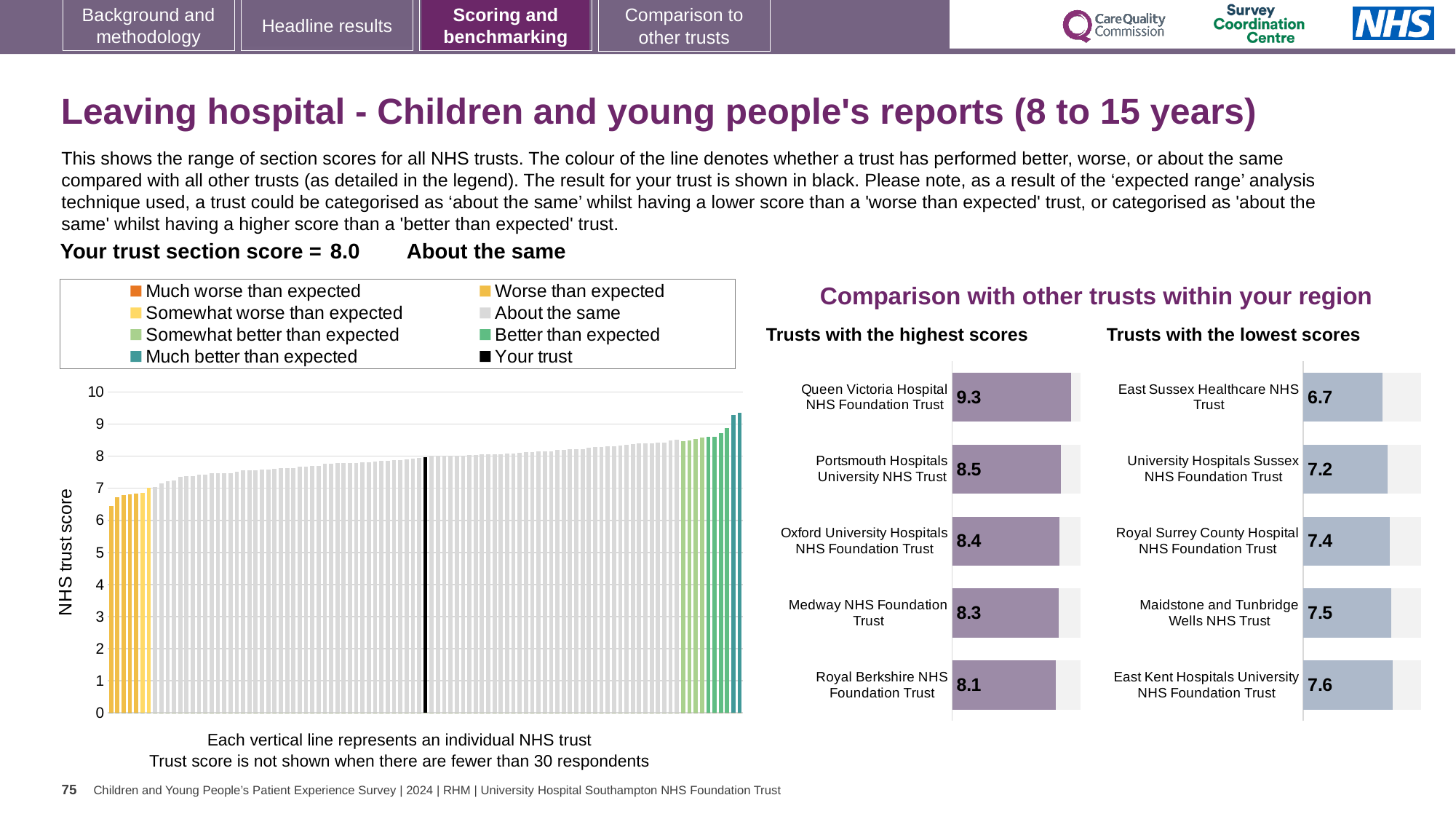
In the large chart on the left, is the value of the rightmost (highest) bar greater or less than 9? greater In the large chart on the left, what is the section score for your trust (the black line)? 8.0 In the 'Trusts with the lowest scores' chart, what is the score for East Sussex Healthcare NHS Trust? 6.7 In the 'Trusts with the highest scores' chart, what is the score for Queen Victoria Hospital NHS Foundation Trust? 9.3 In the 'Trusts with the highest scores' chart, what is the difference between the scores of Queen Victoria Hospital NHS Foundation Trust and Royal Berkshire NHS Foundation Trust? 1.2 In the 'Trusts with the lowest scores' chart, which has the larger score: University Hospitals Sussex NHS Foundation Trust or Royal Surrey County Hospital NHS Foundation Trust? Royal Surrey County Hospital NHS Foundation Trust In the 'Trusts with the highest scores' chart, which trust has the lowest score? Royal Berkshire NHS Foundation Trust In the 'Trusts with the highest scores' chart, what is the score for Medway NHS Foundation Trust? 8.3 In the 'Trusts with the lowest scores' chart, which trust has the highest score? East Kent Hospitals University NHS Foundation Trust In the 'Trusts with the lowest scores' chart, what is the score for Maidstone and Tunbridge Wells NHS Trust? 7.5 How many trusts are shown in the 'Trusts with the lowest scores' chart? 5 How many entries does the legend of the large chart on the left list? 8